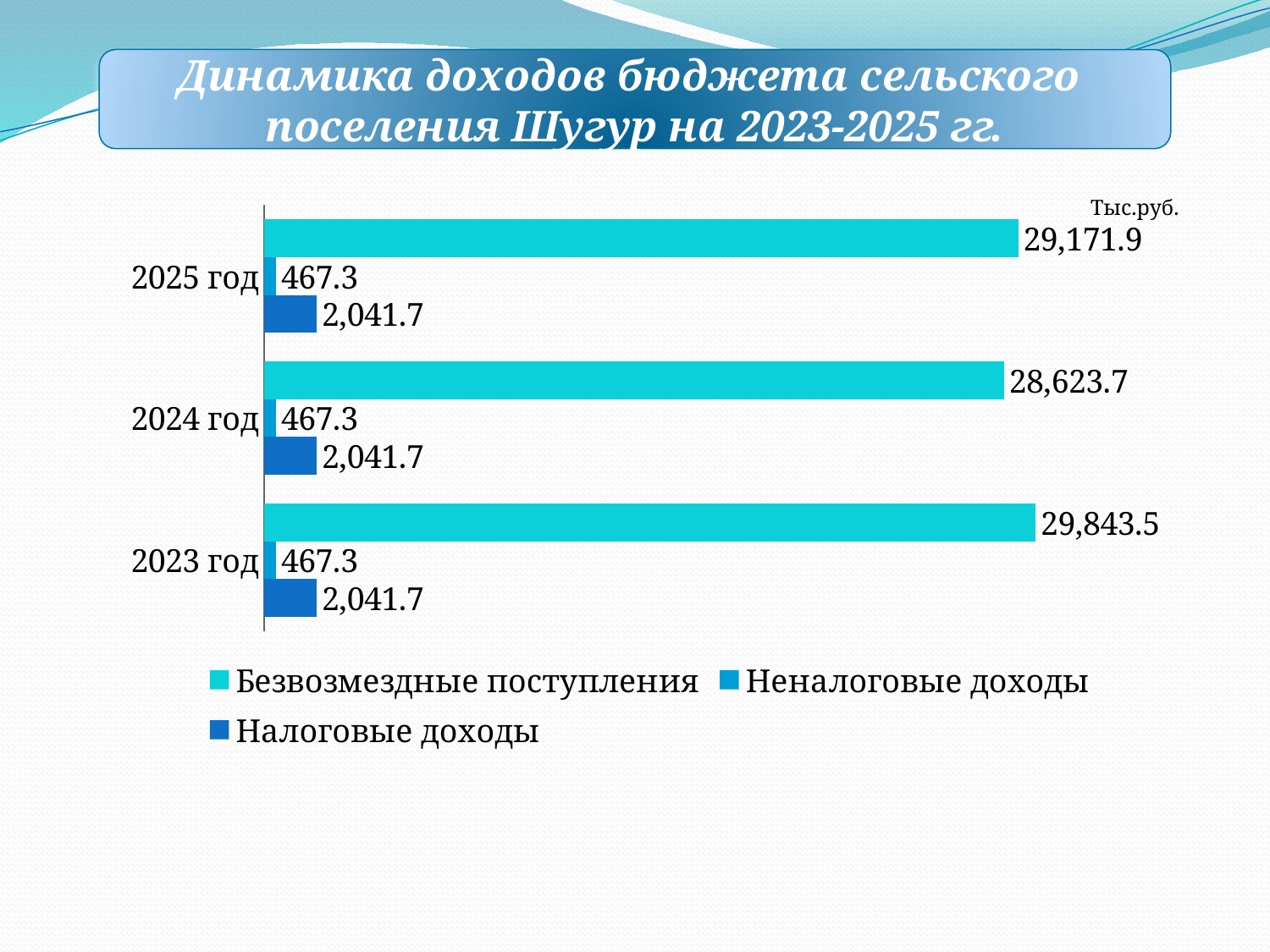
How many series does the legend list? 3 What is the value of Безвозмездные поступления for 2025 год? 29,171.9 What kind of chart is shown on the slide? Bar chart What is the value of Налоговые доходы for 2023 год? 2,041.7 In which year is Безвозмездные поступления lowest? 2024 год What is the difference between Налоговые доходы and Неналоговые доходы in 2025 год? 1,574.4 How many years are shown on the chart? 3 Which is larger: Безвозмездные поступления in 2025 год or in 2024 год? 2025 год What is the value of Безвозмездные поступления for 2024 год? 28,623.7 What is the value of Неналоговые доходы for 2024 год? 467.3 What is the difference between Безвозмездные поступления in 2023 год and 2024 год? 1,219.8 In which year is Безвозмездные поступления highest? 2023 год